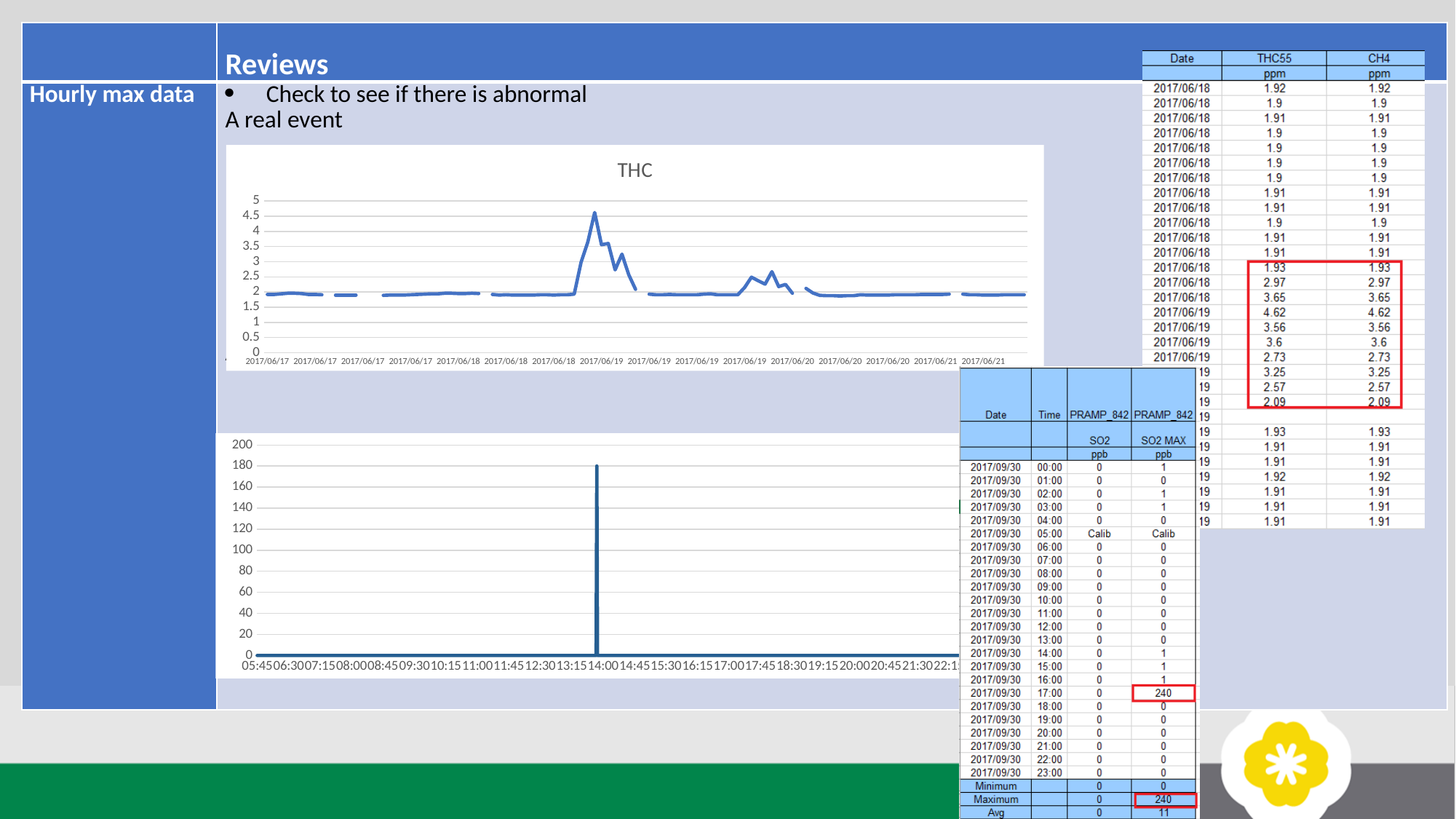
What kind of chart is the chart titled THC? line chart In the THC chart, is the peak value greater or less than 4? greater What is the highest value shown on the y axis of the bottom chart? 200 In the THC chart, is the value on 2017/06/17 greater or less than 3? less In the bottom chart, is the value at 08:00 greater or less than 20? less What is the title of the top chart on the slide? THC In the bottom chart, at which time label does the spike occur? 14:00 In the THC chart, around which date does the line reach its highest point? 2017/06/19